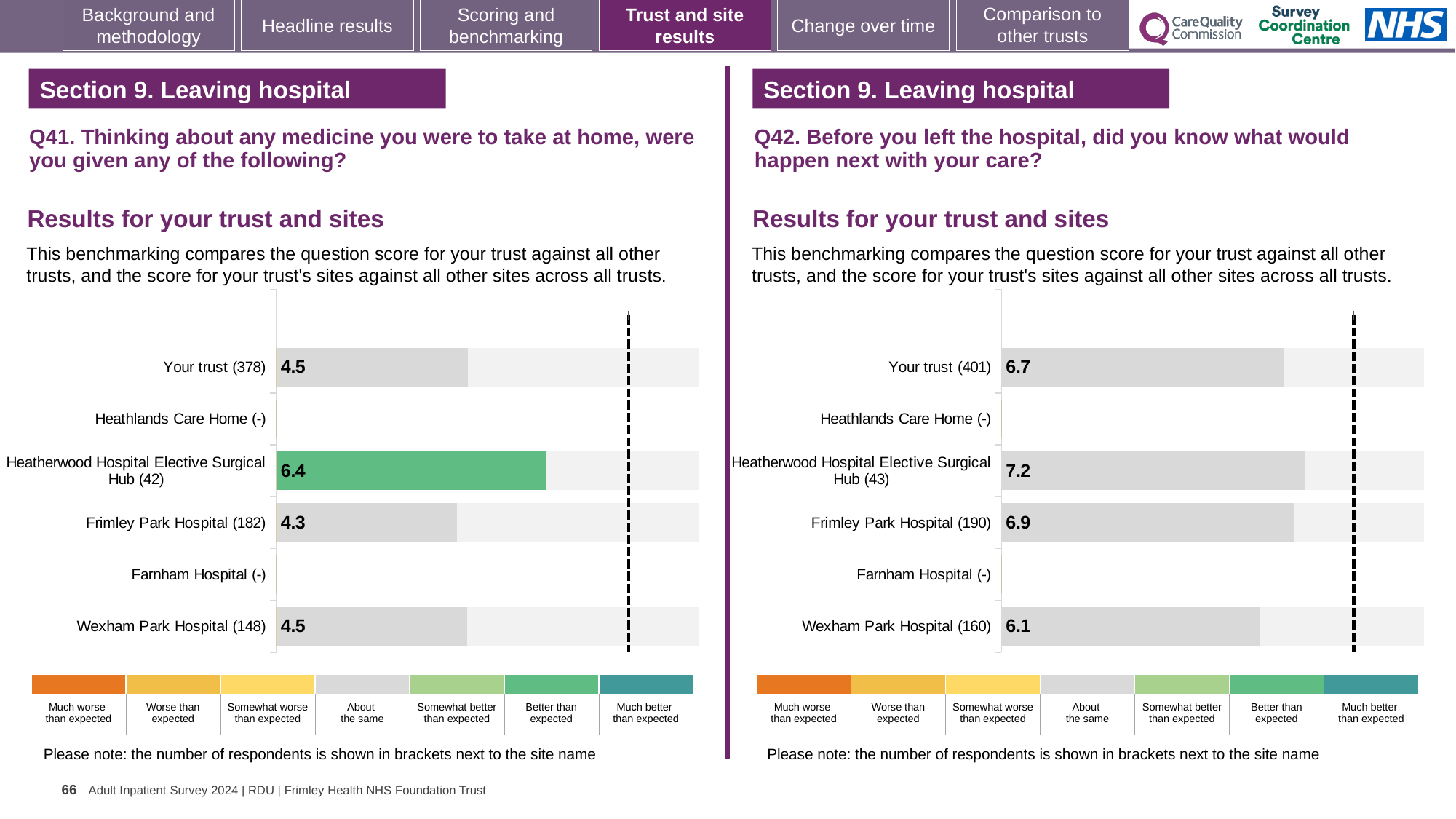
In the Q42 chart on the right, which site has the highest score? Heatherwood Hospital Elective Surgical Hub In the Q41 chart on the left, which site has the lowest score? Frimley Park Hospital In the Q41 chart on the left, which benchmark category does the green colour of the Heatherwood Hospital Elective Surgical Hub bar represent? Better than expected In the Q41 chart on the left, how many respondents are shown for Wexham Park Hospital? 148 What kind of chart is used in the Q41 chart on the left? Bar chart In the Q41 chart on the left, what is the score for Your trust? 4.5 In the Q41 chart on the left, what is the score for Heatherwood Hospital Elective Surgical Hub? 6.4 In the Q42 chart on the right, what is the score for Your trust? 6.7 In the Q42 chart on the right, which is larger, the score for Frimley Park Hospital or Wexham Park Hospital? Frimley Park Hospital How many rows (trust and sites) are listed in the Q42 chart on the right? 6 In the Q41 chart on the left, what is the difference between the scores for Heatherwood Hospital Elective Surgical Hub and Frimley Park Hospital? 2.1 In the Q42 chart on the right, what is the difference between the scores for Heatherwood Hospital Elective Surgical Hub and Wexham Park Hospital? 1.1